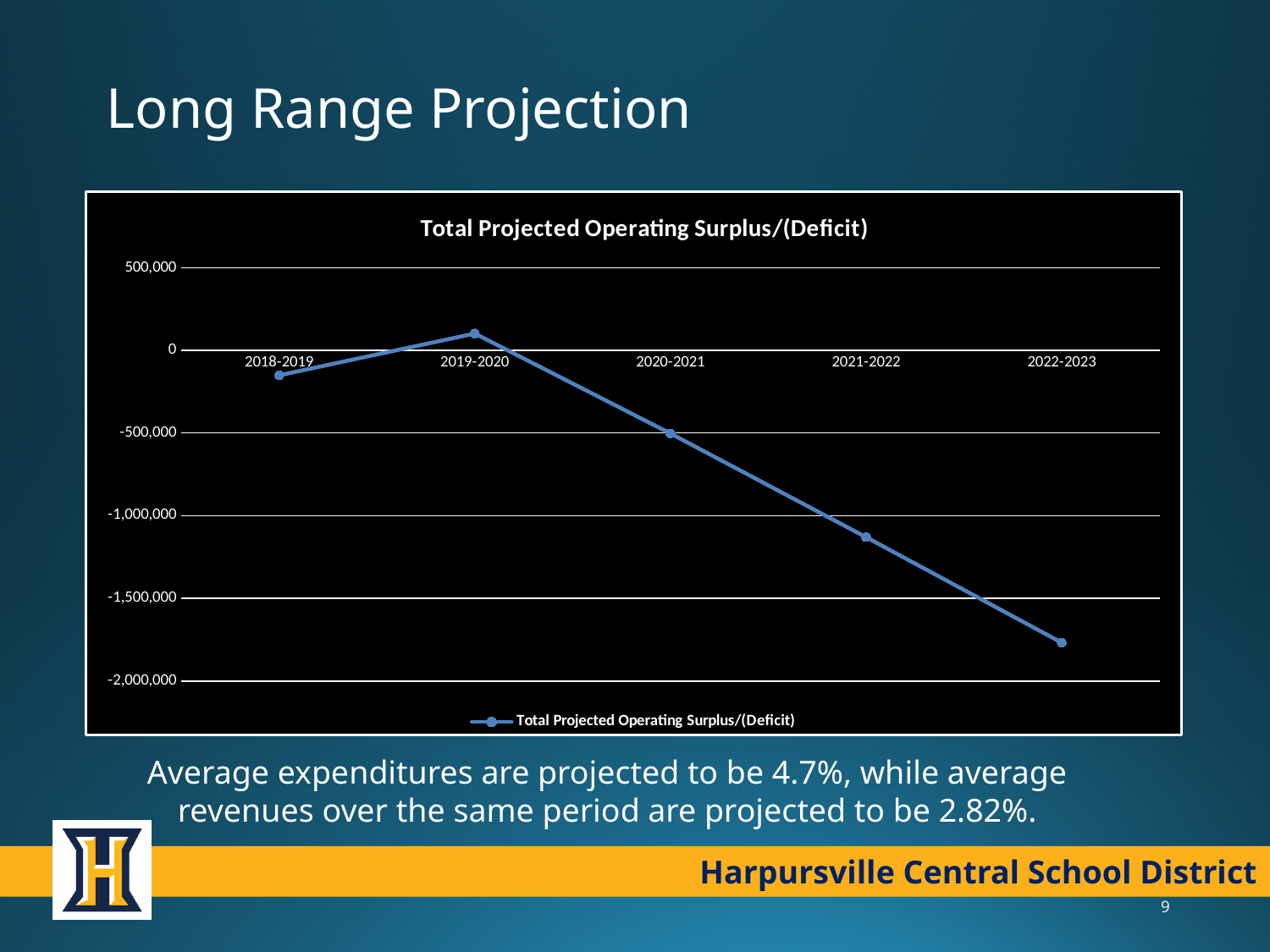
Which year has the lowest projected operating surplus/(deficit)? 2022-2023 Is the value for 2022-2023 greater or less than -1,500,000? less Is the value for 2019-2020 greater or less than 0? greater How many series does the legend list? 1 Which year has the highest projected operating surplus/(deficit)? 2019-2020 Which is larger, the value for 2020-2021 or the value for 2021-2022? 2020-2021 Is the value for 2021-2022 greater or less than -1,000,000? less From 2019-2020 to 2022-2023, do the values rise or fall? fall What kind of chart is shown on the slide? line chart What is the title of the chart? Total Projected Operating Surplus/(Deficit) How many data points are plotted on the line? 5